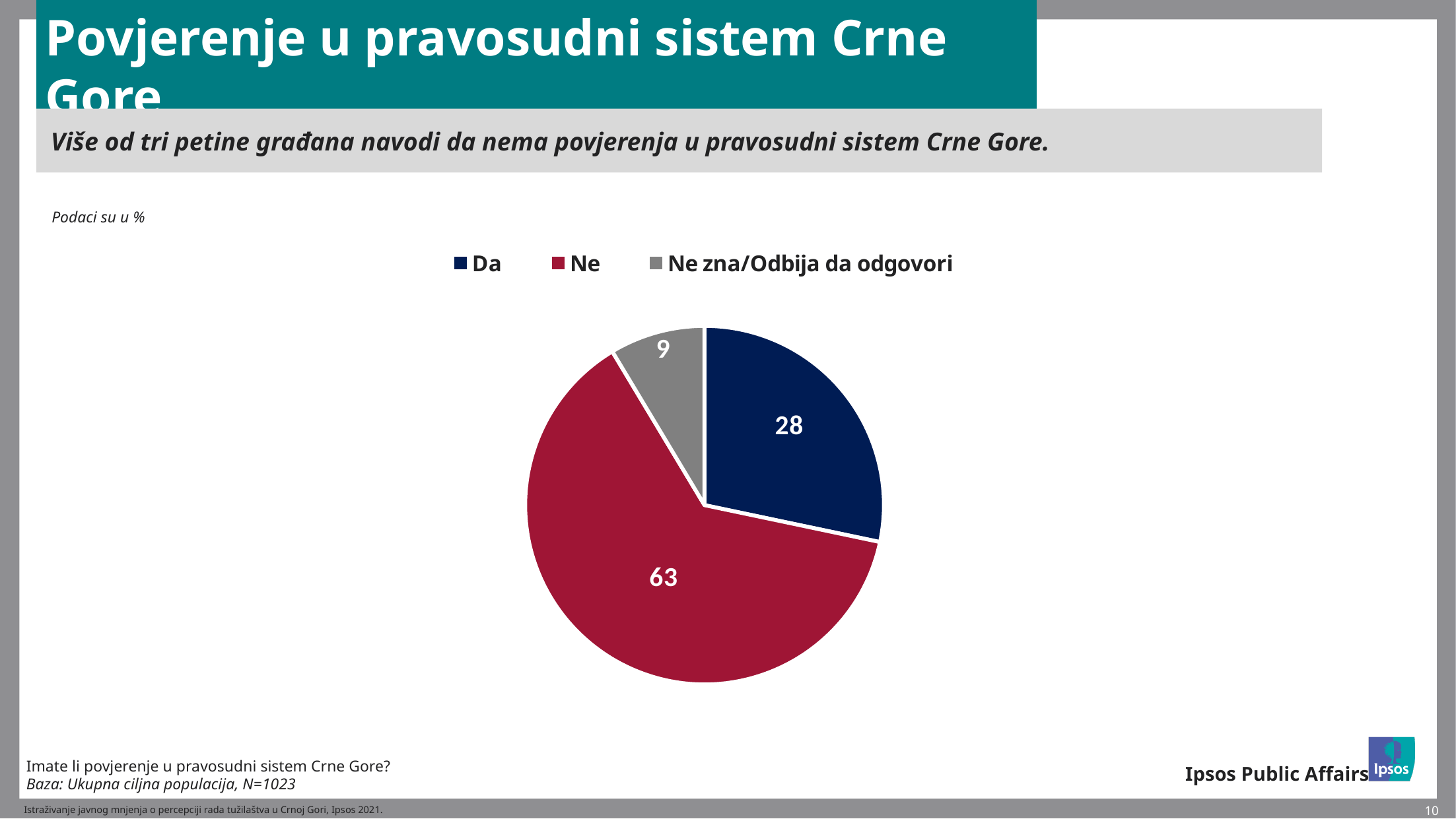
How many slices does the pie chart have? 3 What is the difference between the values for "Ne" and "Da"? 35 How many entries does the legend list? 3 What is the difference between the values for "Da" and "Ne zna/Odbija da odgovori"? 19 Which category has the smallest slice of the pie chart? Ne zna/Odbija da odgovori What is the value for "Ne" in the pie chart? 63 What is the value for "Da" in the pie chart? 28 Which category has the largest slice of the pie chart? Ne What kind of chart is shown on the slide? pie chart Which is larger, the value for "Da" or the value for "Ne"? Ne What colour is the "Ne" slice in the pie chart? red What is the value for "Ne zna/Odbija da odgovori" in the pie chart? 9